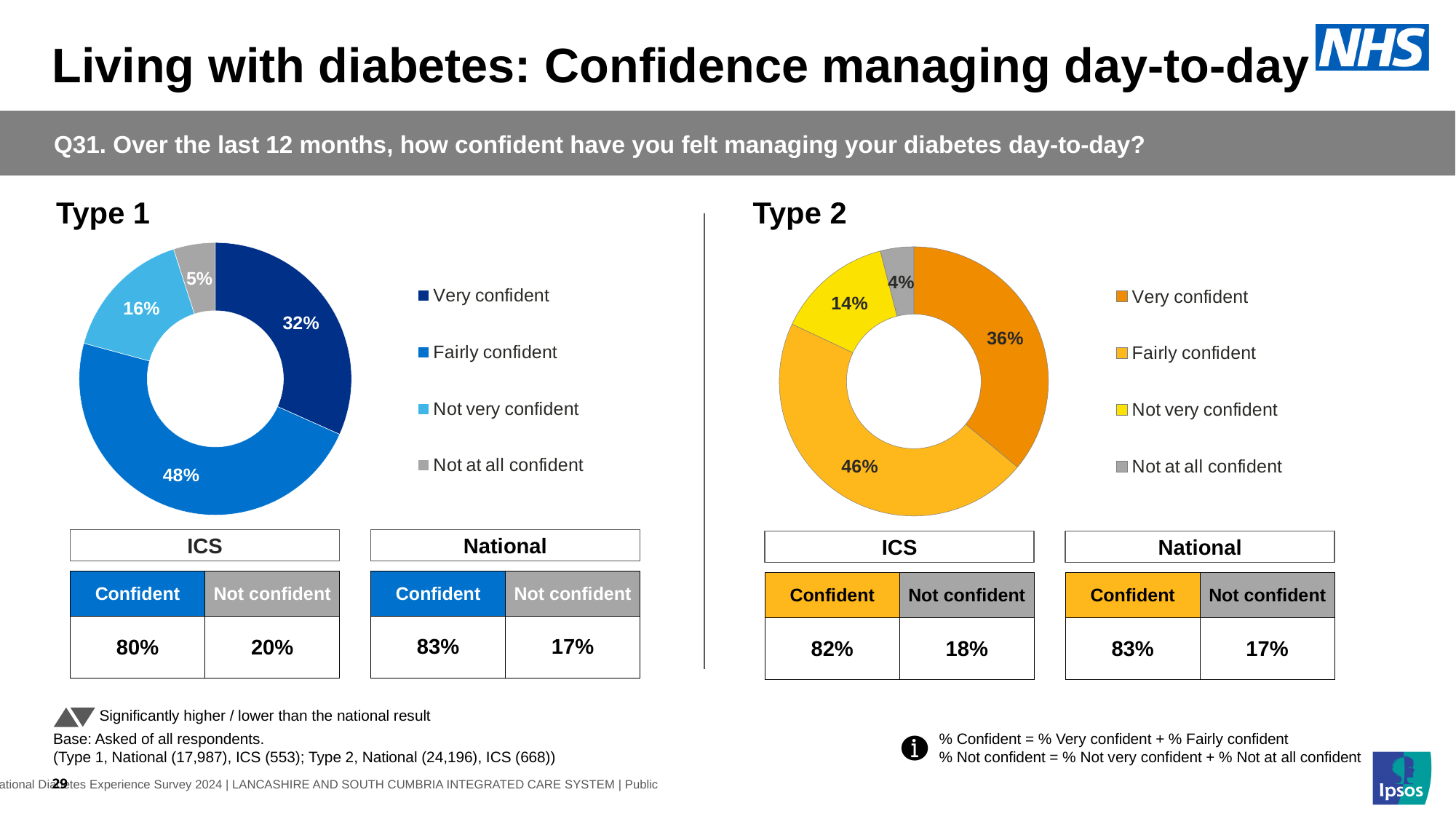
In the Type 2 chart, which is larger: the Not very confident share or the Not at all confident share? Not very confident In the Type 2 chart, what percentage of respondents were Not at all confident? 4% In the Type 2 chart, what percentage of respondents were Fairly confident? 46% In the Type 1 chart, what colour represents Not at all confident? Grey What kind of chart is used for Type 2? Doughnut (pie) chart In the Type 2 chart, what is the combined share of Very confident and Fairly confident? 82% How many categories does the Type 1 chart show? 4 In the Type 1 chart, what percentage of respondents were Very confident? 32% In the Type 1 chart, what is the difference between the Fairly confident and Very confident shares? 16 percentage points In the Type 1 chart, what percentage of respondents were Not very confident? 16% In the Type 1 chart, which category has the largest share? Fairly confident In the Type 2 chart, which category has the smallest share? Not at all confident